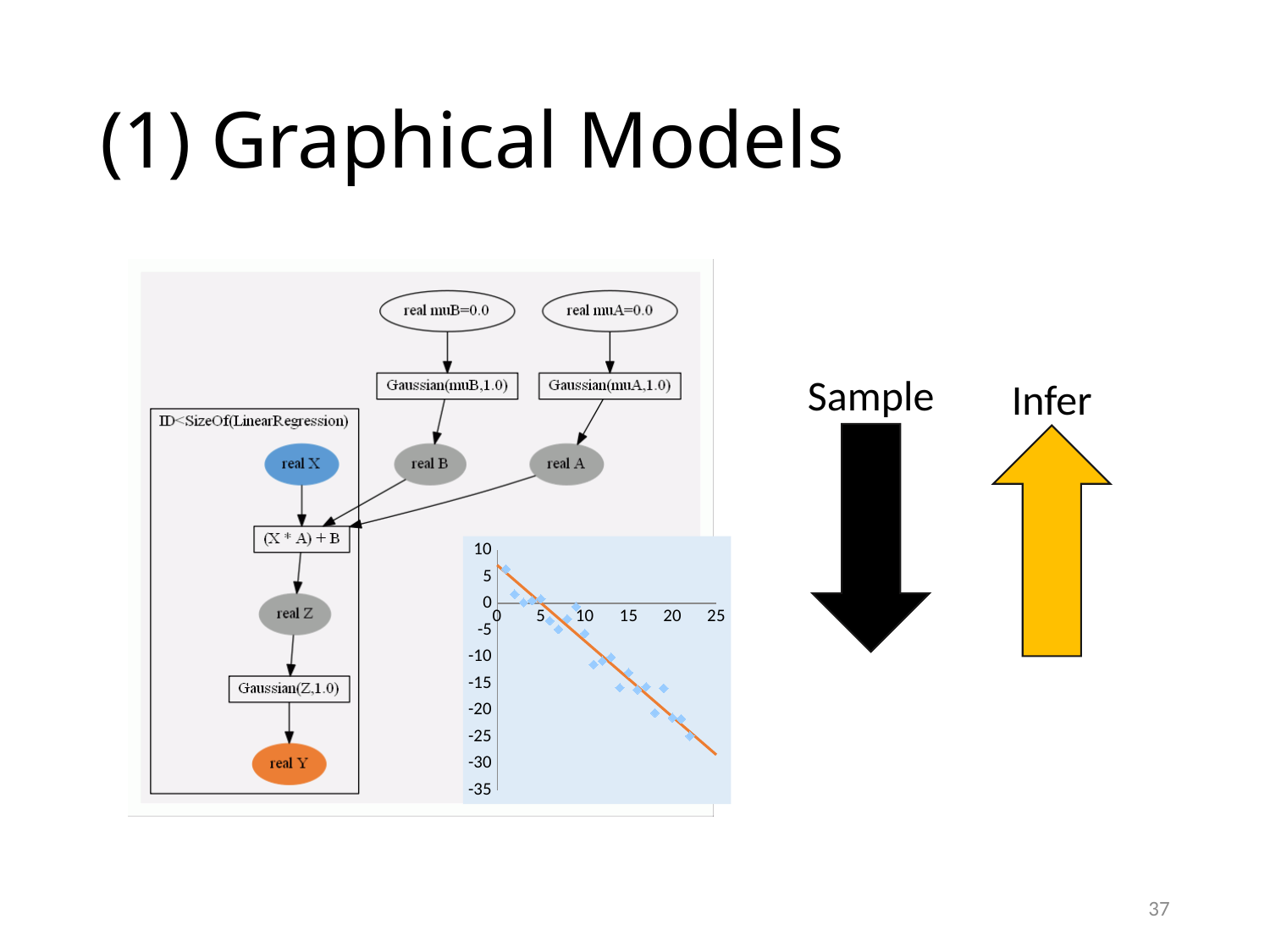
Is the value of the point plotted near x=11 greater or less than -5? less Is the value of the point plotted near x=1 greater or less than 5? greater Is the value of the point plotted near x=22 greater or less than -20? less What is the highest value shown on the x axis of the chart? 25 What kind of chart is shown on the slide? scatter chart What is the lowest value shown on the y axis of the chart? -35 Which is larger, the value of the point near x=3 or the value of the point near x=20? the point near x=3 Do the plotted values rise or fall as x increases along the x axis? fall